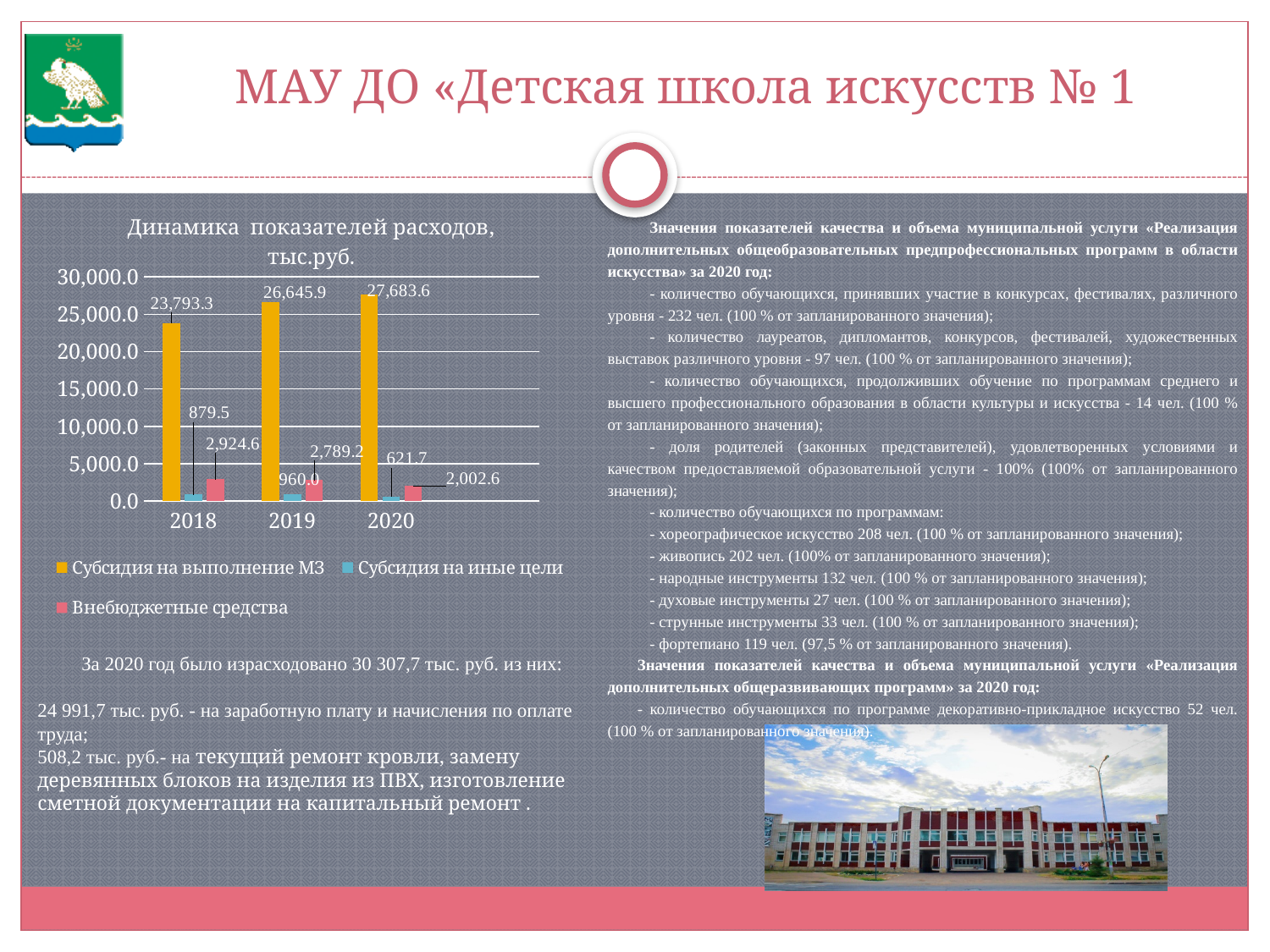
Does Субсидия на выполнение МЗ rise or fall from 2018 to 2020? rise In which year is Субсидия на выполнение МЗ the highest? 2020 In which year is Внебюджетные средства the lowest? 2020 What is the value of Внебюджетные средства for 2018? 2,924.6 Which is larger: Внебюджетные средства in 2019 or in 2020? 2019 What is the value of Субсидия на иные цели for 2019? 960.0 What kind of chart is shown on the slide? bar chart What is the value of Субсидия на иные цели for 2020? 621.7 What is the difference between Субсидия на выполнение МЗ in 2020 and in 2018? 3,890.3 What is the value of Субсидия на выполнение МЗ for 2019? 26,645.9 How many series does the chart legend list? 3 How many years are shown on the x axis of the chart? 3